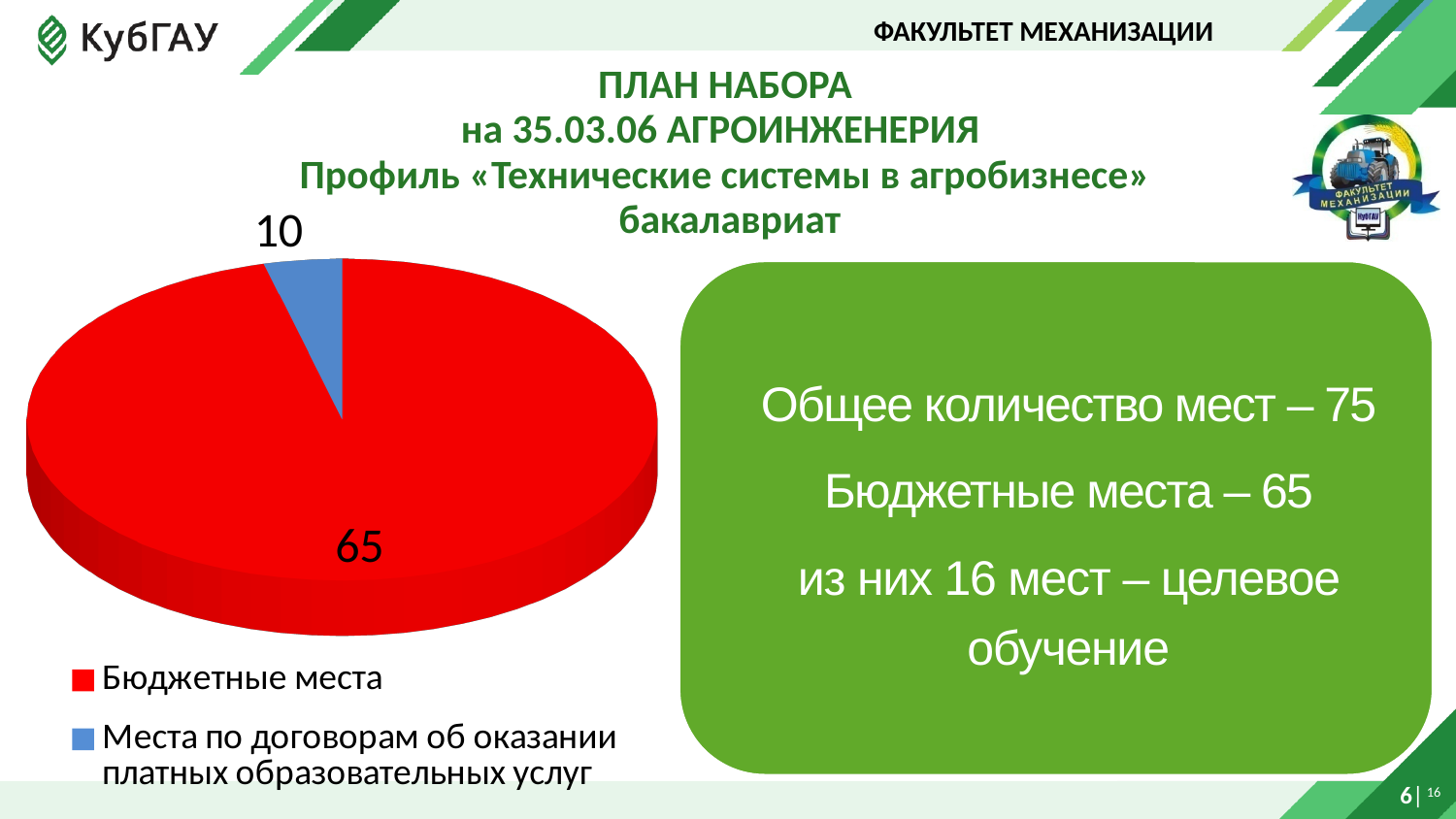
What kind of chart is shown on the slide? pie chart What is the difference between the value for Бюджетные места and the value for Места по договорам об оказании платных образовательных услуг? 55 How many entries does the legend of the pie chart list? 2 Which category has the largest slice in the pie chart? Бюджетные места Which category has the smallest slice in the pie chart? Места по договорам об оказании платных образовательных услуг How many slices does the pie chart have? 2 What is the value for Бюджетные места in the pie chart? 65 What is the total of all slices in the pie chart? 75 What is the value for Места по договорам об оказании платных образовательных услуг in the pie chart? 10 Which is larger: the value for Бюджетные места or the value for Места по договорам об оказании платных образовательных услуг? Бюджетные места What colour is the slice for Места по договорам об оказании платных образовательных услуг in the pie chart? blue What colour is the slice for Бюджетные места in the pie chart? red